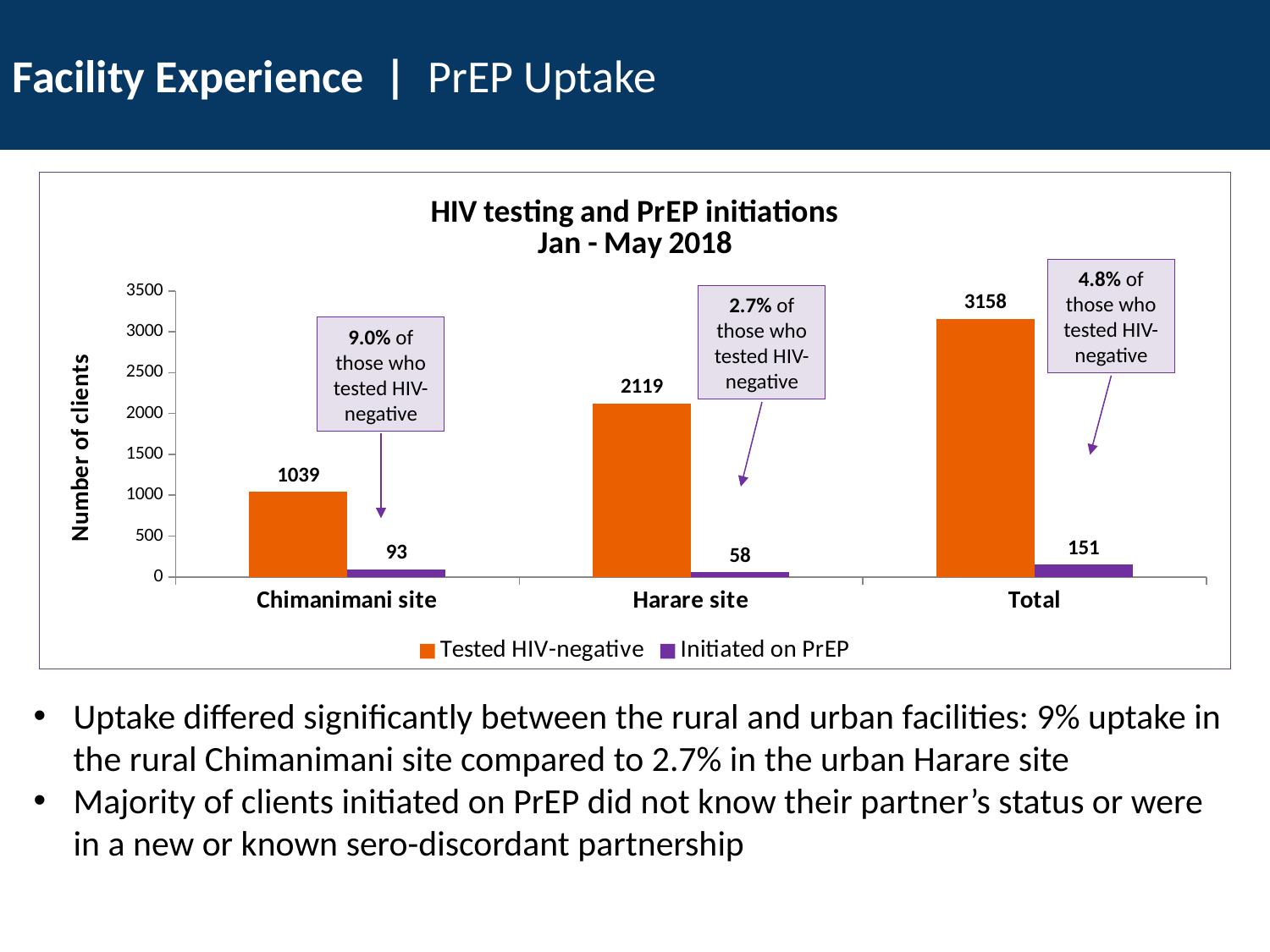
What is the total number of clients initiated on PrEP? 151 What percentage of those who tested HIV-negative at the Harare site were initiated on PrEP, according to the annotation? 2.7% Which site has the lowest number of clients initiated on PrEP? Harare site How many categories are shown on the x axis? 3 Is the number of clients tested HIV-negative at the Chimanimani site greater or less than 1500? less How many clients tested HIV-negative at the Harare site? 2119 What kind of chart is shown on the slide? Bar chart Which category has the highest number of clients tested HIV-negative? Total How many series does the legend list? 2 What is the difference between the number tested HIV-negative at the Harare site and at the Chimanimani site? 1080 Which site had more clients initiated on PrEP, Chimanimani or Harare? Chimanimani site How many clients were initiated on PrEP at the Chimanimani site? 93